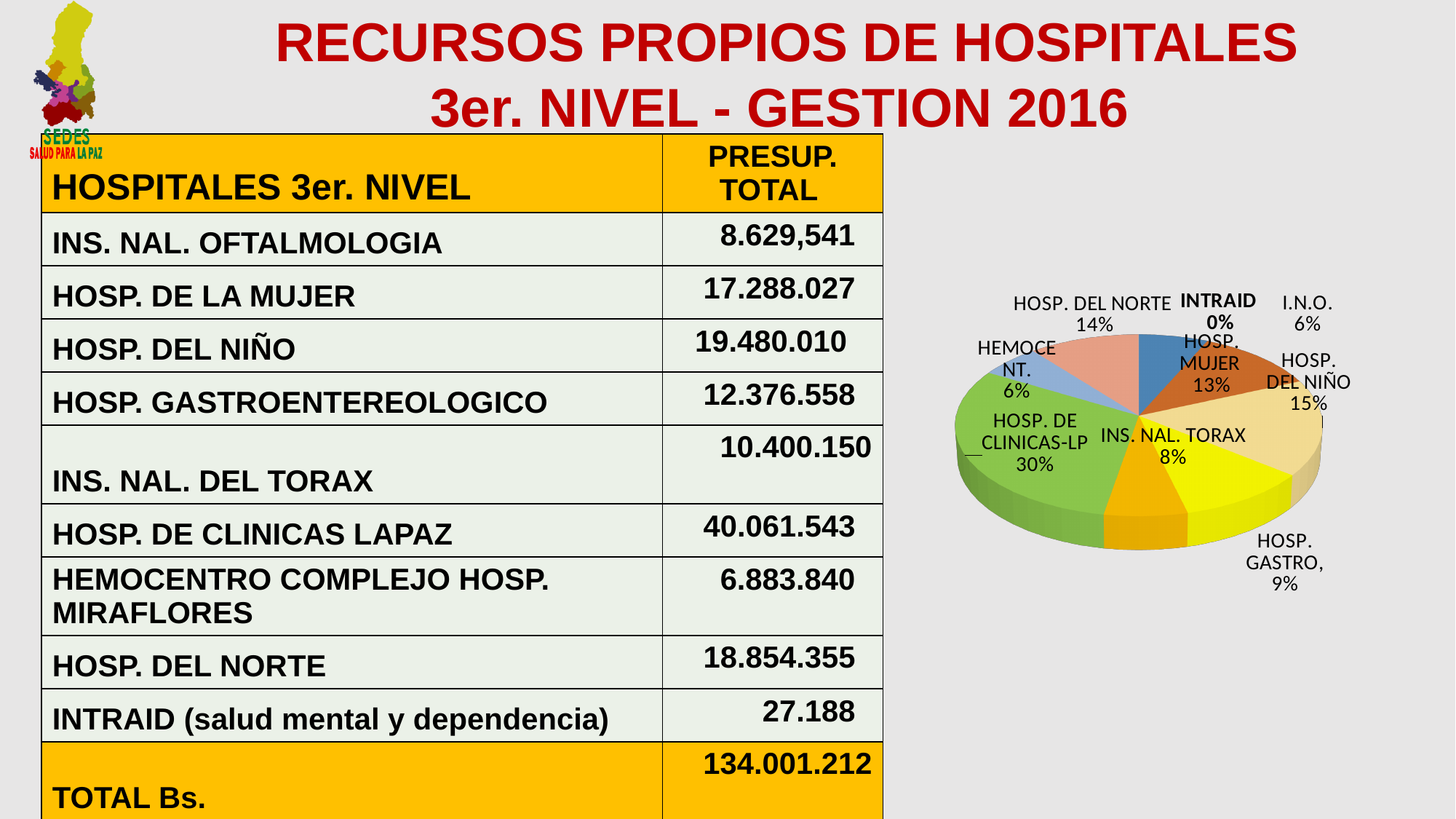
Which slice of the pie chart is the largest? HOSP. DE CLINICAS-LP Which is larger in the pie chart, HOSP. MUJER or HOSP. GASTRO? HOSP. MUJER What percentage is shown for INTRAID in the pie chart? 0% What is the difference in percentage points between HOSP. DE CLINICAS-LP and HOSP. DEL NIÑO? 15 What share of the pie does HOSP. DEL NIÑO represent? 15% What share of the pie does HOSP. DE CLINICAS-LP represent? 30% Which slice of the pie chart is the smallest? INTRAID What kind of chart is shown on the slide? pie chart How many slices does the pie chart have? 9